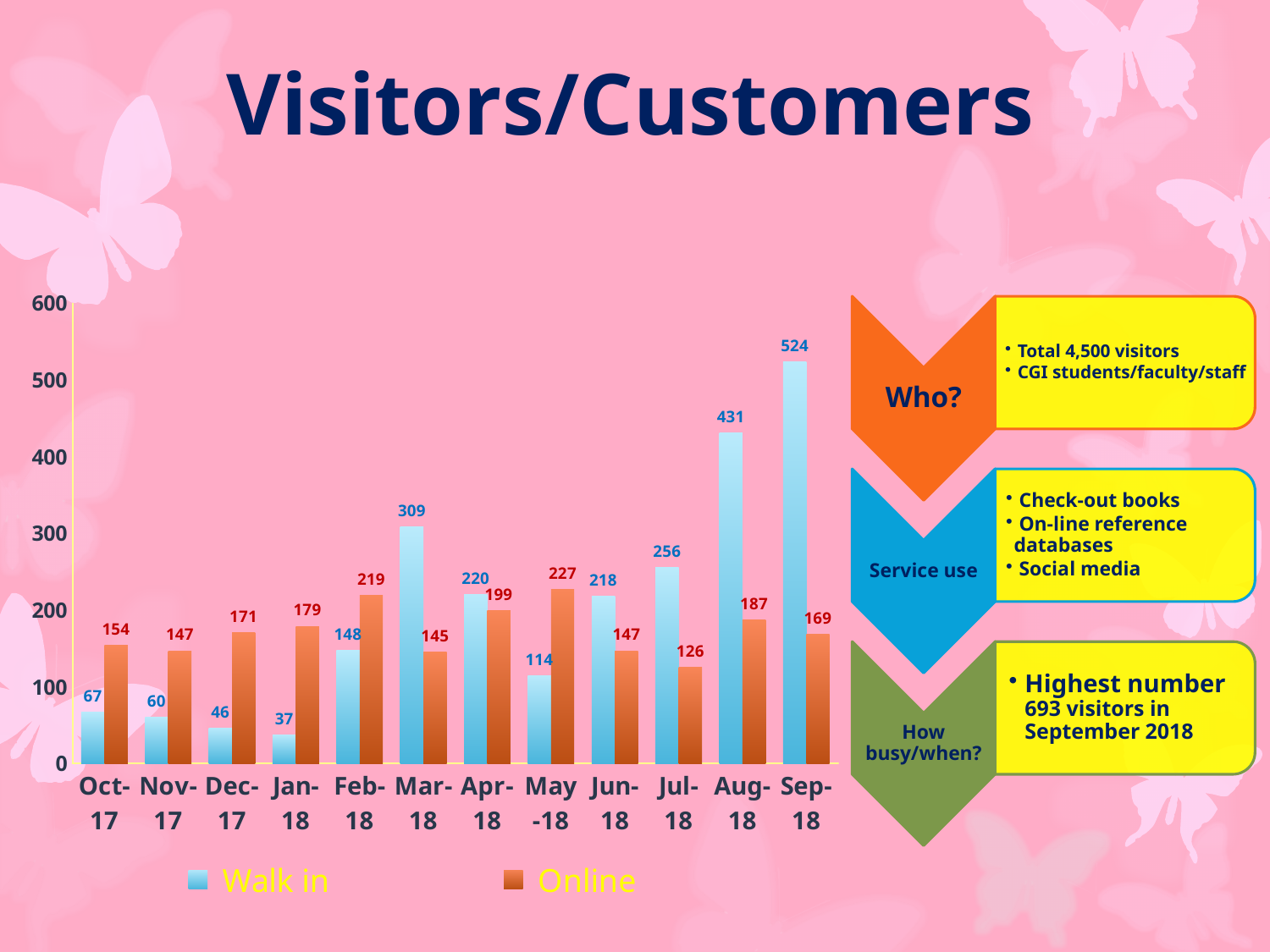
Which series is shown in light blue in the legend? Walk in What is the Online value for May-18? 227 What is the Walk in value for Sep-18? 524 What is the Walk in value for Jan-18? 37 Which is larger for Mar-18, the Walk in value or the Online value? Walk in Which month has the lowest Online value? Jul-18 What is the total of Walk in and Online for Sep-18? 693 Which month has the highest Walk in value? Sep-18 What is the difference between the Walk in and Online values for Aug-18? 244 How many series does the legend list? 2 How many months are shown on the x axis? 12 What kind of chart is shown on the slide? Bar chart